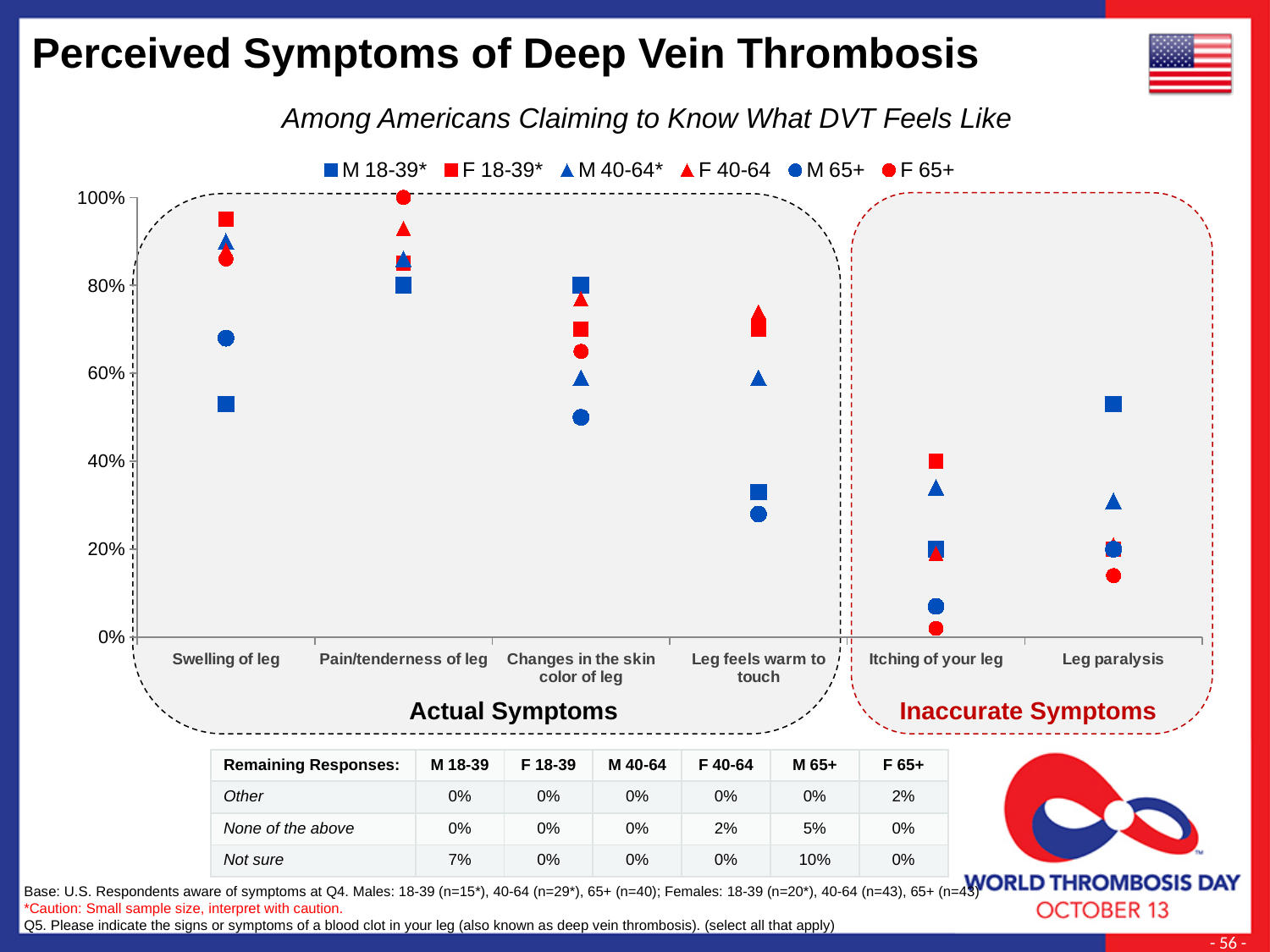
What kind of chart is shown on the slide? scatter chart For Leg feels warm to touch, which is larger: the value for M 40-64 or for M 65+? M 40-64 Is the value for F 18-39 for Itching of your leg greater or less than 20%? greater Is the value for M 65+ for Leg feels warm to touch greater or less than 40%? less Is the value for M 18-39 for Leg paralysis greater or less than 40%? greater How many symptom categories are plotted along the x axis? 6 For Swelling of leg, which is larger: the value for F 18-39 or for M 18-39? F 18-39 How many series does the legend list? 6 Which two categories are grouped under the label 'Inaccurate Symptoms'? Itching of your leg and Leg paralysis